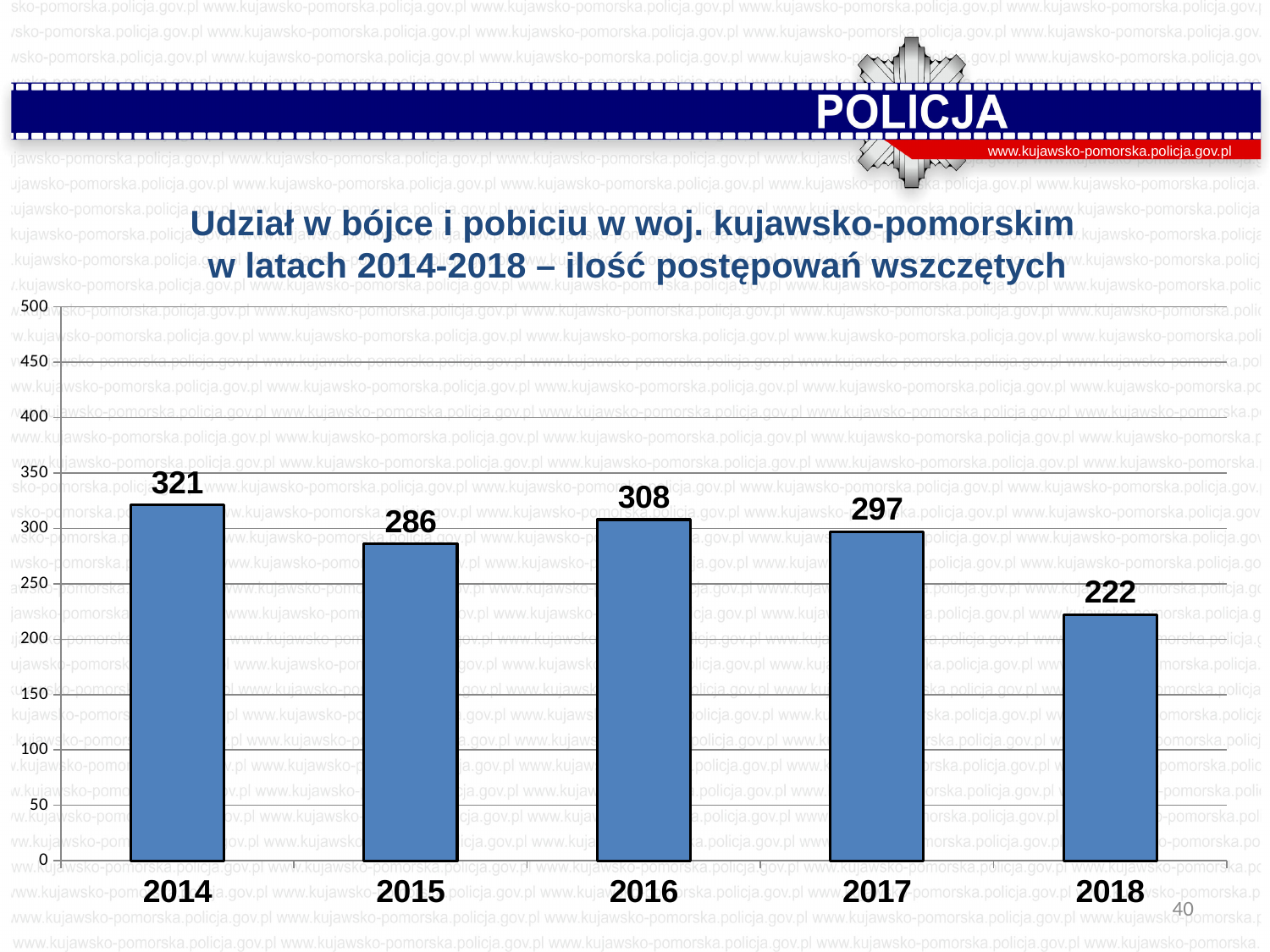
Is the value for 2015 greater or less than 300? less What is the value for 2018? 222 What is the difference between the values for 2014 and 2018? 99 What is the value for 2014? 321 What is the value for 2016? 308 Which is larger, the value for 2015 or the value for 2017? 2017 What is the difference between the values for 2016 and 2017? 11 Which year has the highest value? 2014 What kind of chart is shown on the slide? bar chart Which year has the lowest value? 2018 What is the title of the chart? Udział w bójce i pobiciu w woj. kujawsko-pomorskim w latach 2014-2018 – ilość postępowań wszczętych How many years are shown on the x axis? 5